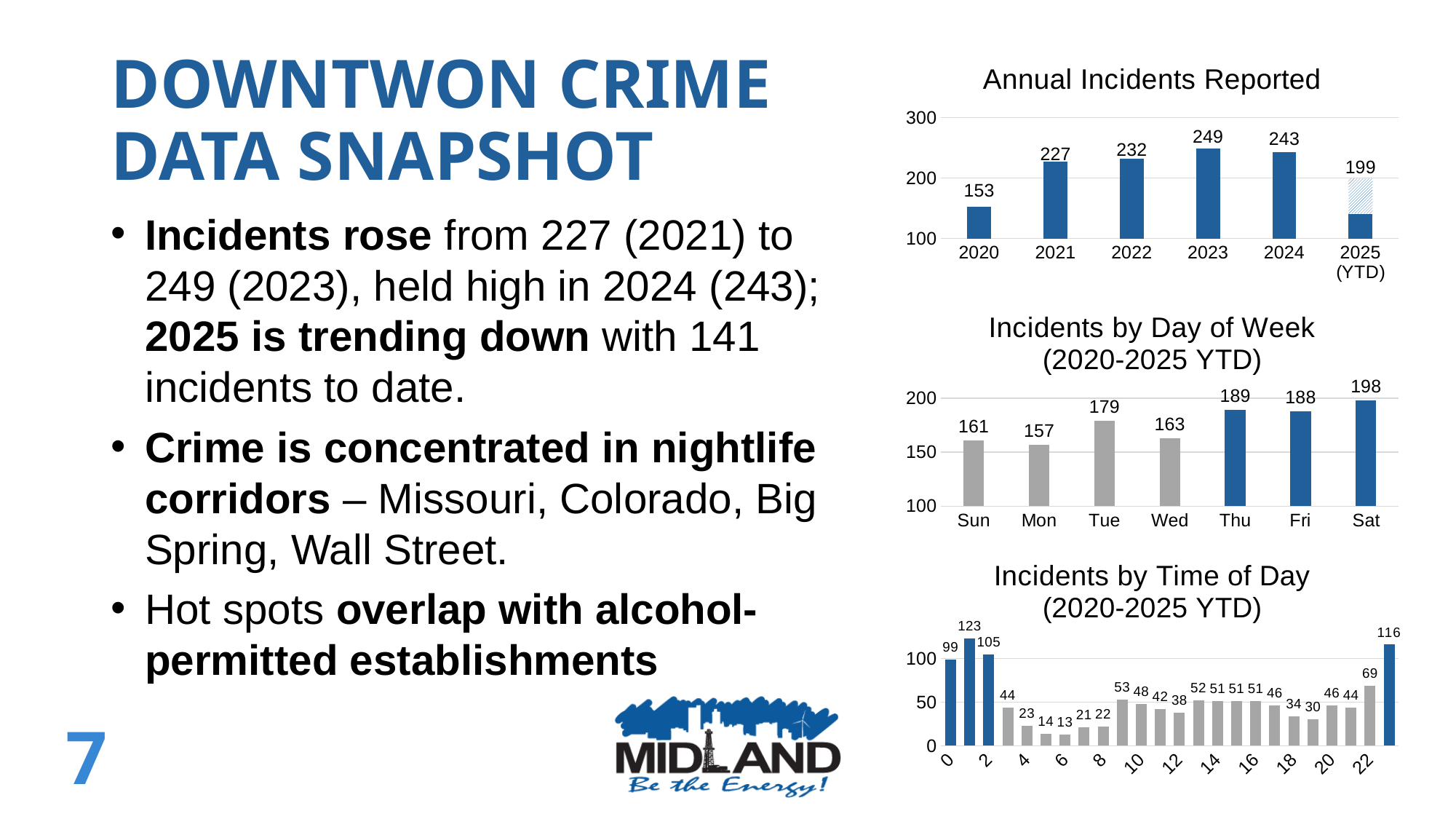
In the 'Incidents by Time of Day (2020-2025 YTD)' chart, which hour has the highest number of incidents? 1 In the 'Incidents by Day of Week (2020-2025 YTD)' chart, what is the value for Thu? 189 In the 'Annual Incidents Reported' chart, how many years are shown on the x axis? 6 In the 'Annual Incidents Reported' chart, which year has the highest number of incidents? 2023 In the 'Incidents by Time of Day (2020-2025 YTD)' chart, what is the value for hour 22? 69 In the 'Annual Incidents Reported' chart, how many incidents were reported in 2021? 227 What kind of chart is 'Incidents by Time of Day (2020-2025 YTD)'? bar chart In the 'Annual Incidents Reported' chart, what is the difference between the 2023 and 2021 values? 22 In the 'Incidents by Day of Week (2020-2025 YTD)' chart, which day has the highest number of incidents? Sat In the 'Incidents by Day of Week (2020-2025 YTD)' chart, which day has the lowest number of incidents? Mon In the 'Incidents by Day of Week (2020-2025 YTD)' chart, which is larger, the value for Tue or the value for Wed? Tue